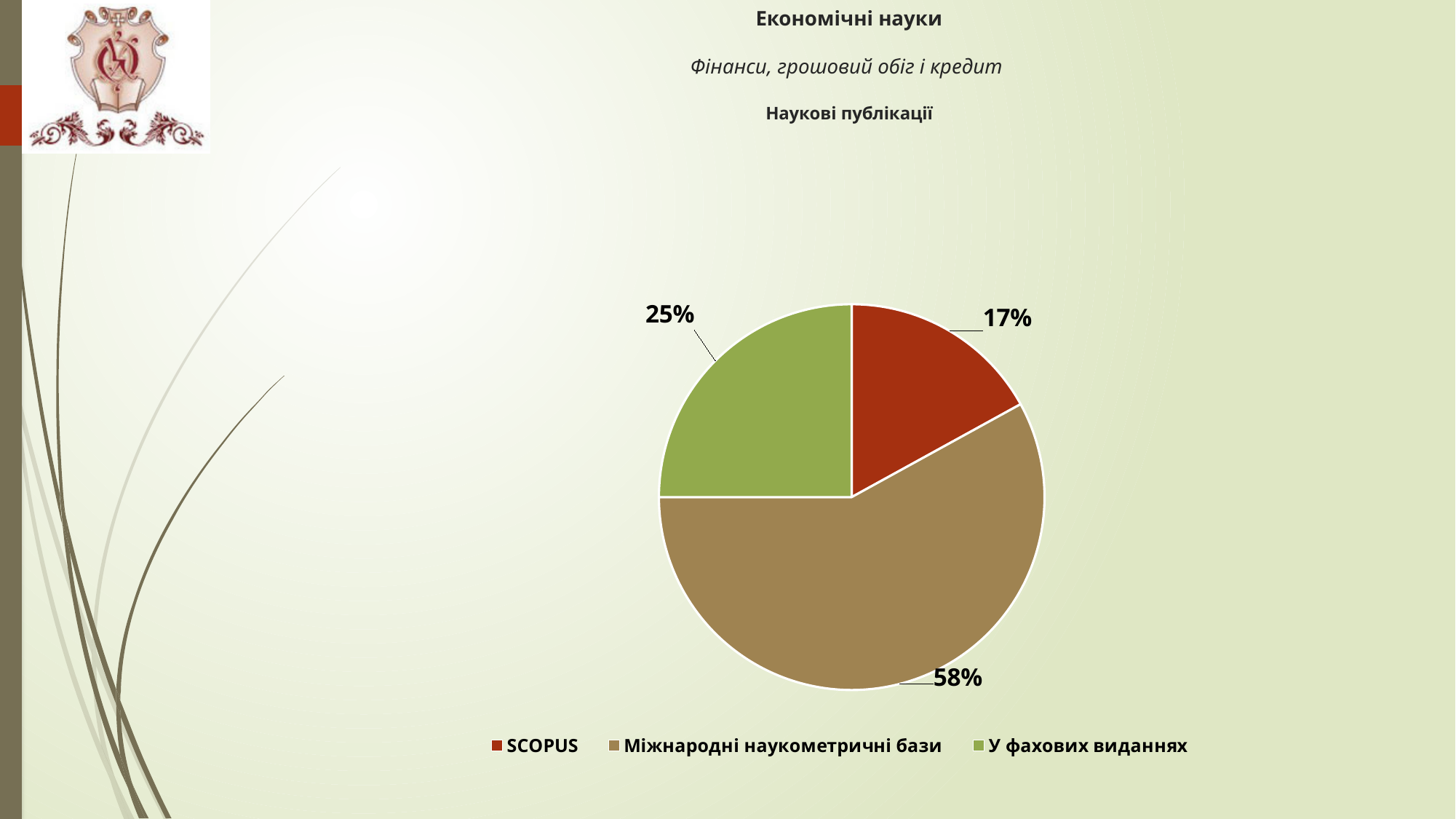
What share of the pie does У фахових виданнях have? 25% What is the difference in percentage points between У фахових виданнях and SCOPUS? 8 What kind of chart is shown on the slide? pie chart What is the difference in percentage points between Міжнародні наукометричні бази and У фахових виданнях? 33 How many slices does the pie chart have? 3 What colour is the slice for SCOPUS? red What share of the pie does Міжнародні наукометричні бази have? 58% Which is larger, the share for SCOPUS or the share for У фахових виданнях? У фахових виданнях Which category has the largest slice of the pie? Міжнародні наукометричні бази Which category has the smallest slice of the pie? SCOPUS How many entries does the legend list? 3 What share of the pie does SCOPUS have? 17%